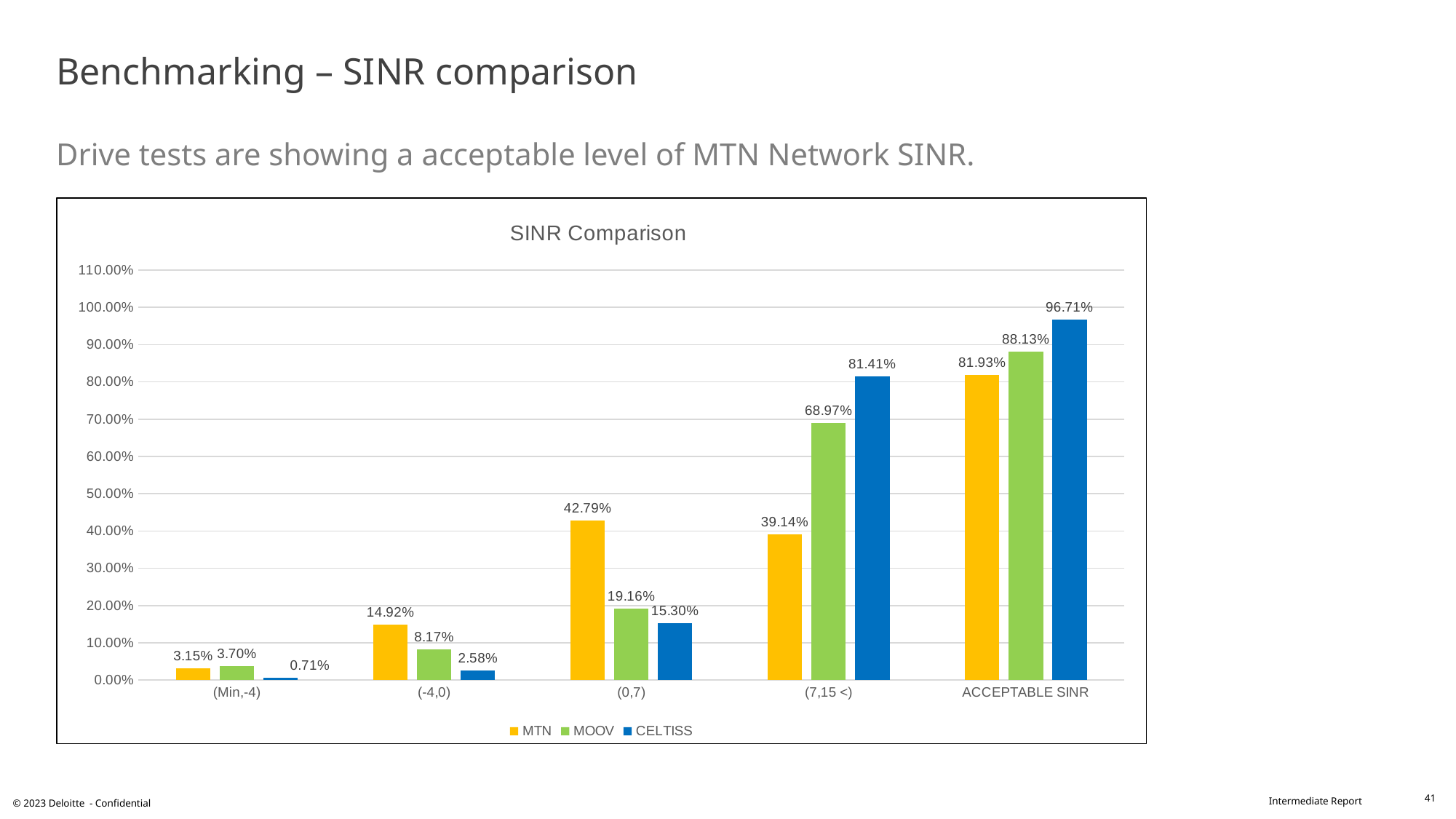
Which series has the lowest value in the (Min,-4) category? CELTISS What is the difference between the CELTISS and MTN values for ACCEPTABLE SINR? 14.78% What is the MOOV value for the (7,15 <) category? 68.97% How many series does the legend list? 3 What is the CELTISS value for ACCEPTABLE SINR? 96.71% What is the MTN value for the (0,7) category? 42.79% What is the difference between the MTN and MOOV values in the (0,7) category? 23.63% Is the CELTISS value for (7,15 <) greater or less than 80.00%? greater In the (-4,0) category, which is larger: the MTN value or the MOOV value? MTN How many categories are shown on the x axis? 5 Which series has the highest value in the ACCEPTABLE SINR category? CELTISS What kind of chart is shown on the slide? Bar chart